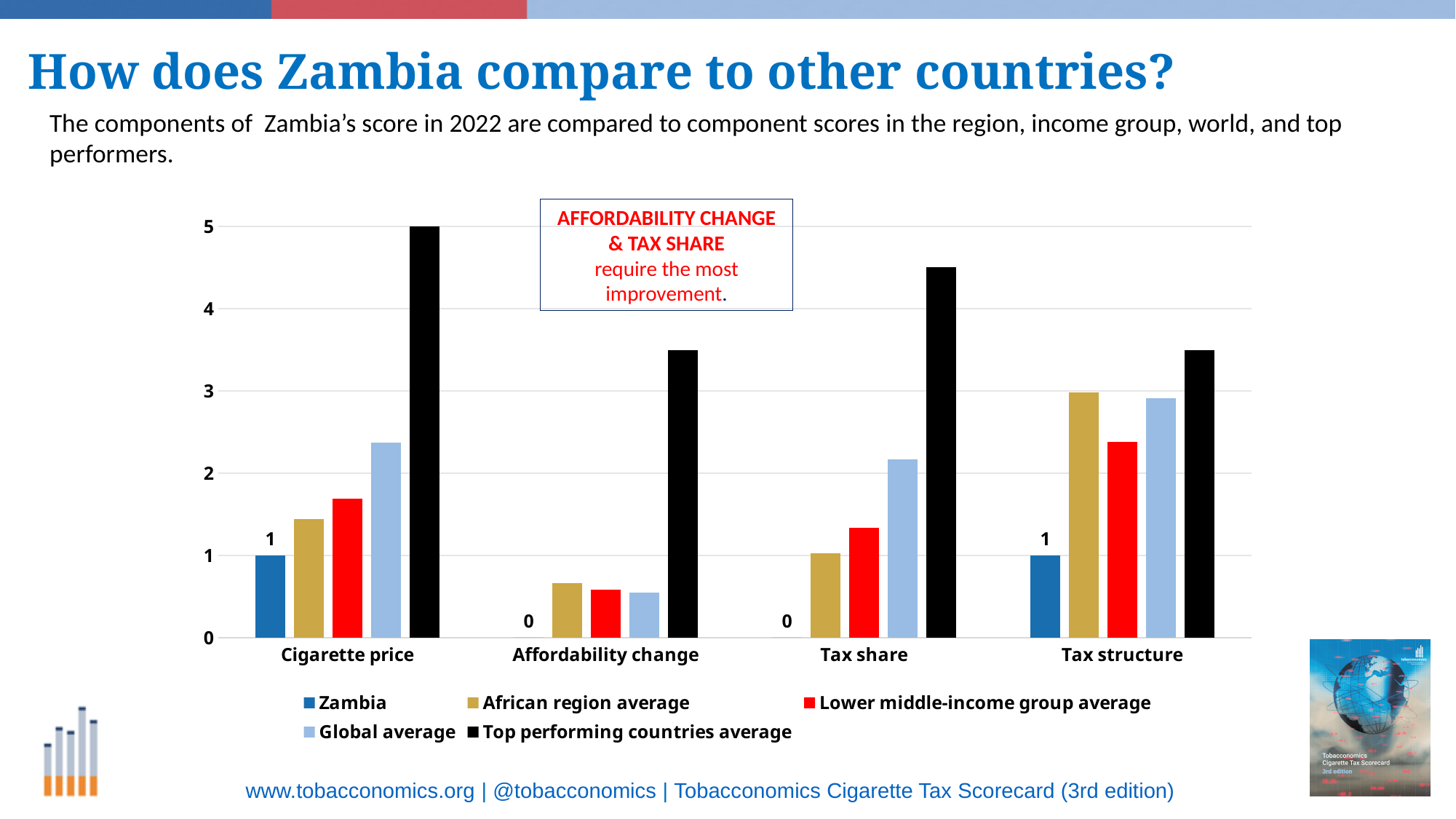
What is Zambia's score for Cigarette price? 1 Which series has the highest score for Affordability change? Top performing countries average Is the Top performing countries average for Tax share greater or less than 4? greater What is the Top performing countries average score for Cigarette price? 5 For Tax structure, which is larger: the African region average or the Lower middle-income group average? African region average How many score components (categories) are shown on the x axis? 4 What is Zambia's score for Affordability change? 0 What is Zambia's score for Tax structure? 1 What is the difference between the Top performing countries average and Zambia's score for Cigarette price? 4 How many series does the legend list? 5 What kind of chart is shown on the slide? Bar chart What is Zambia's score for Tax share? 0